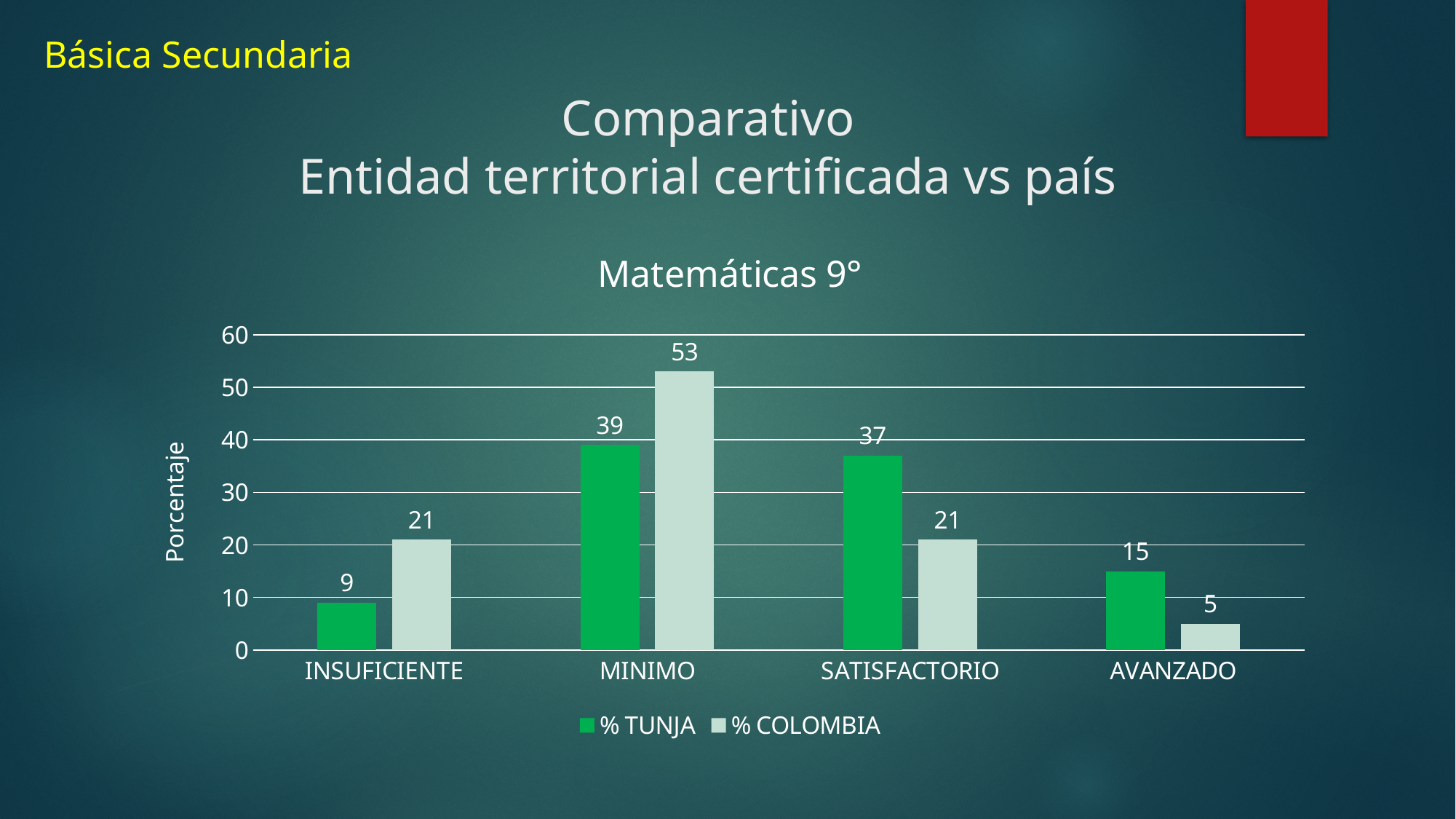
What kind of chart is shown? bar chart How many series does the legend list? 2 What is the difference between the % COLOMBIA and % TUNJA values for MINIMO? 14 How many categories are shown on the x axis? 4 Which category has the highest % COLOMBIA value? MINIMO Which is larger for SATISFACTORIO, % TUNJA or % COLOMBIA? % TUNJA Which category has the lowest % TUNJA value? INSUFICIENTE What is the % TUNJA value for AVANZADO? 15 Is the % COLOMBIA value for AVANZADO greater or less than 10? less What is the % COLOMBIA value for INSUFICIENTE? 21 What is the % TUNJA value for MINIMO? 39 What is the title of the chart? Matemáticas 9°